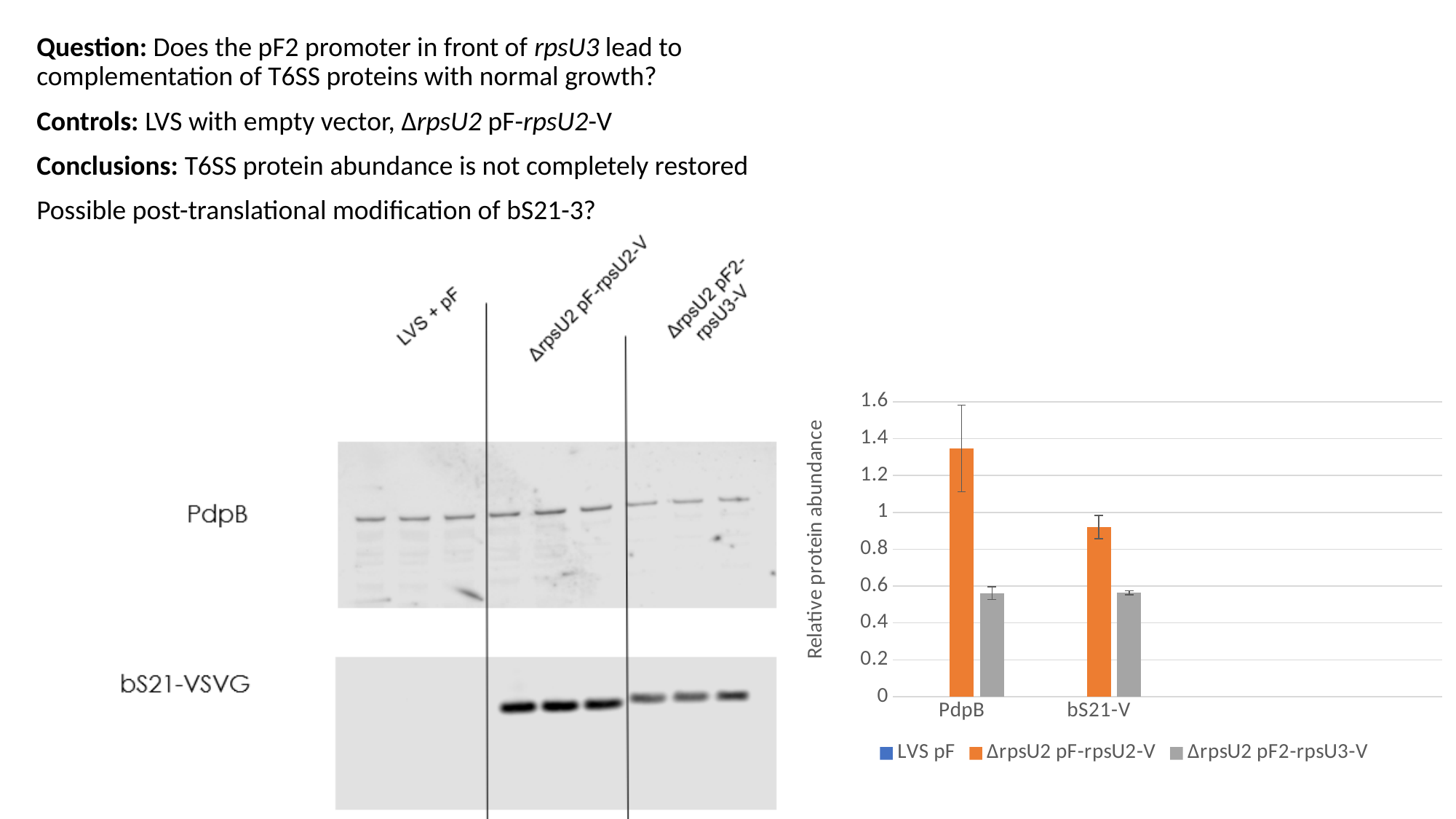
How many categories are shown on the x axis of the bar chart? 2 In the bar chart, is the value for ΔrpsU2 pF-rpsU2-V at bS21-V greater or less than 1? less In the bar chart, for PdpB, which series has the larger value: ΔrpsU2 pF-rpsU2-V or ΔrpsU2 pF2-rpsU3-V? ΔrpsU2 pF-rpsU2-V In the bar chart, is the value for ΔrpsU2 pF2-rpsU3-V at bS21-V greater or less than 0.8? less What kind of chart is shown on the right side of the slide? bar chart In the bar chart, is the value for ΔrpsU2 pF-rpsU2-V at PdpB greater or less than 1.2? greater In the bar chart, which category has the highest bar overall? PdpB Which series in the bar chart is shown in orange? ΔrpsU2 pF-rpsU2-V How many series does the legend of the bar chart list? 3 In the bar chart, for the ΔrpsU2 pF-rpsU2-V series, which category has the larger value: PdpB or bS21-V? PdpB What is the y-axis title of the bar chart? Relative protein abundance